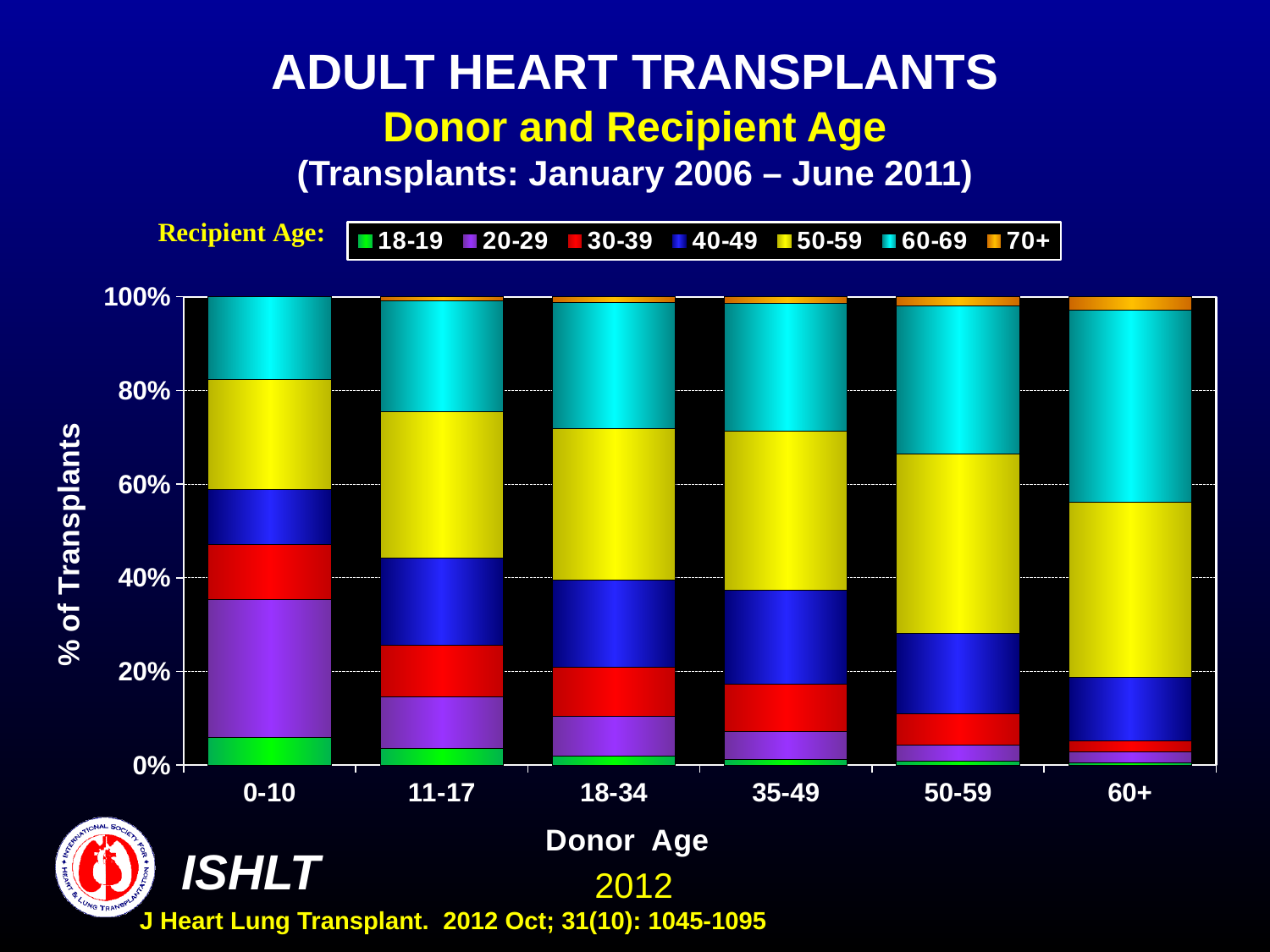
How many donor age groups are shown along the x axis? 6 Is the share of recipients aged 60-69 among donors aged 60+ greater or less than 20%? greater What time period of transplants does the chart cover, according to the subtitle? January 2006 – June 2011 As donor age increases from 0-10 to 60+, does the share of recipients aged 20-29 rise or fall? fall What kind of chart is shown on the slide? Stacked bar chart Is the share of recipients aged 20-29 among donors aged 0-10 greater or less than 20%? greater Which donor age group has the largest share of recipients aged 20-29? 0-10 How many recipient age groups does the legend list? 7 Which donor age group has a larger share of recipients aged 30-39: 0-10 or 60+? 0-10 What is the label of the y axis? % of Transplants Which donor age group has the largest share of recipients aged 60-69? 60+ Which donor age group has the largest share of recipients aged 18-19? 0-10